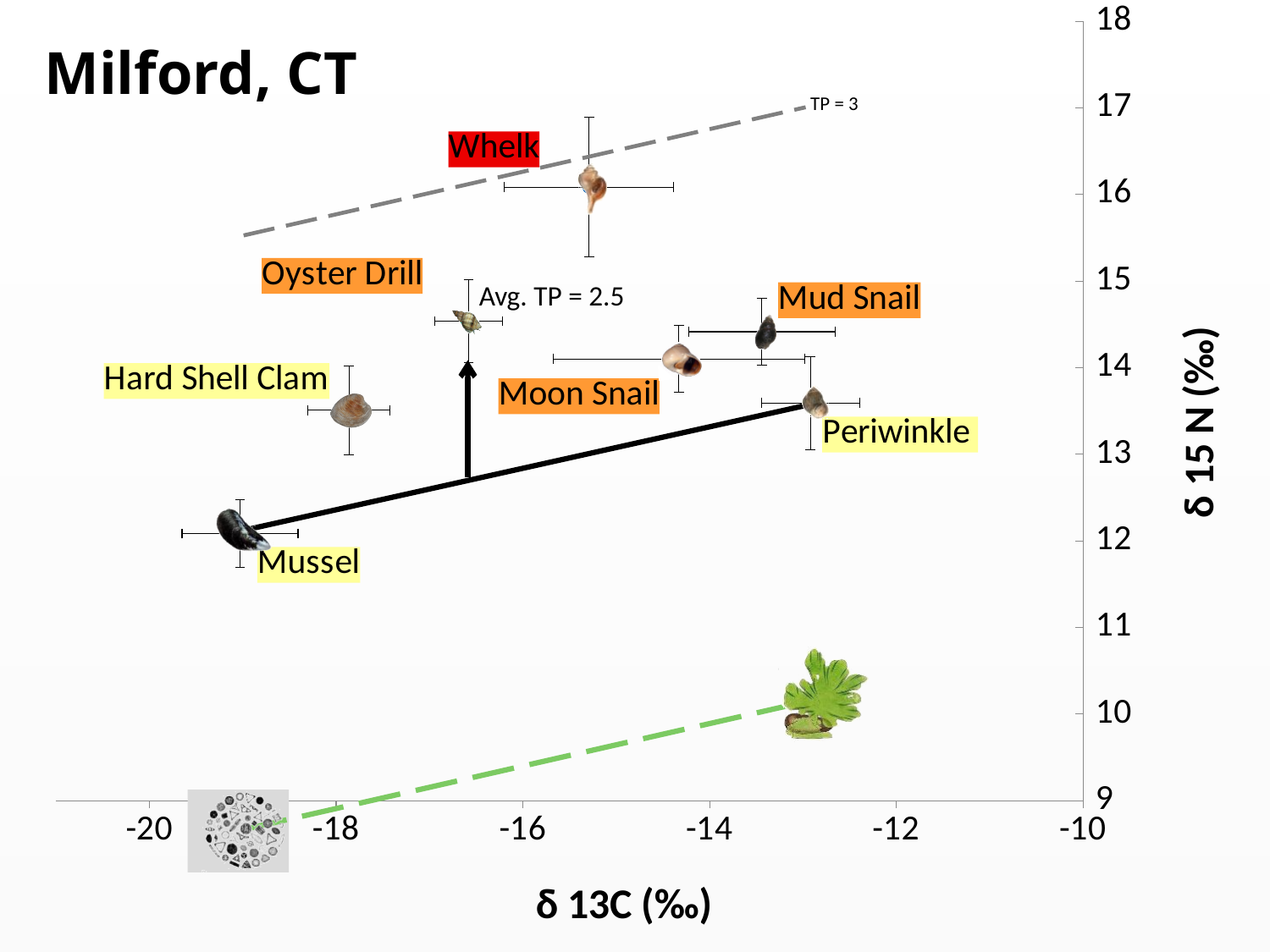
Is the δ 13C value for Periwinkle greater or less than -14? greater What is the title of the chart? Milford, CT Which species has the lowest δ 15 N value? Mussel What kind of chart is shown on the slide? scatter plot Which has the higher δ 15 N value, Oyster Drill or Hard Shell Clam? Oyster Drill Is the δ 13C value for Hard Shell Clam greater or less than -17? less Which species has the highest δ 15 N value? Whelk How many labeled species are plotted on the chart? 7 Which species has the lowest (most negative) δ 13C value? Mussel Is the δ 15 N value for Mussel greater or less than 13? less What is the label on the y axis? δ 15 N (‰)